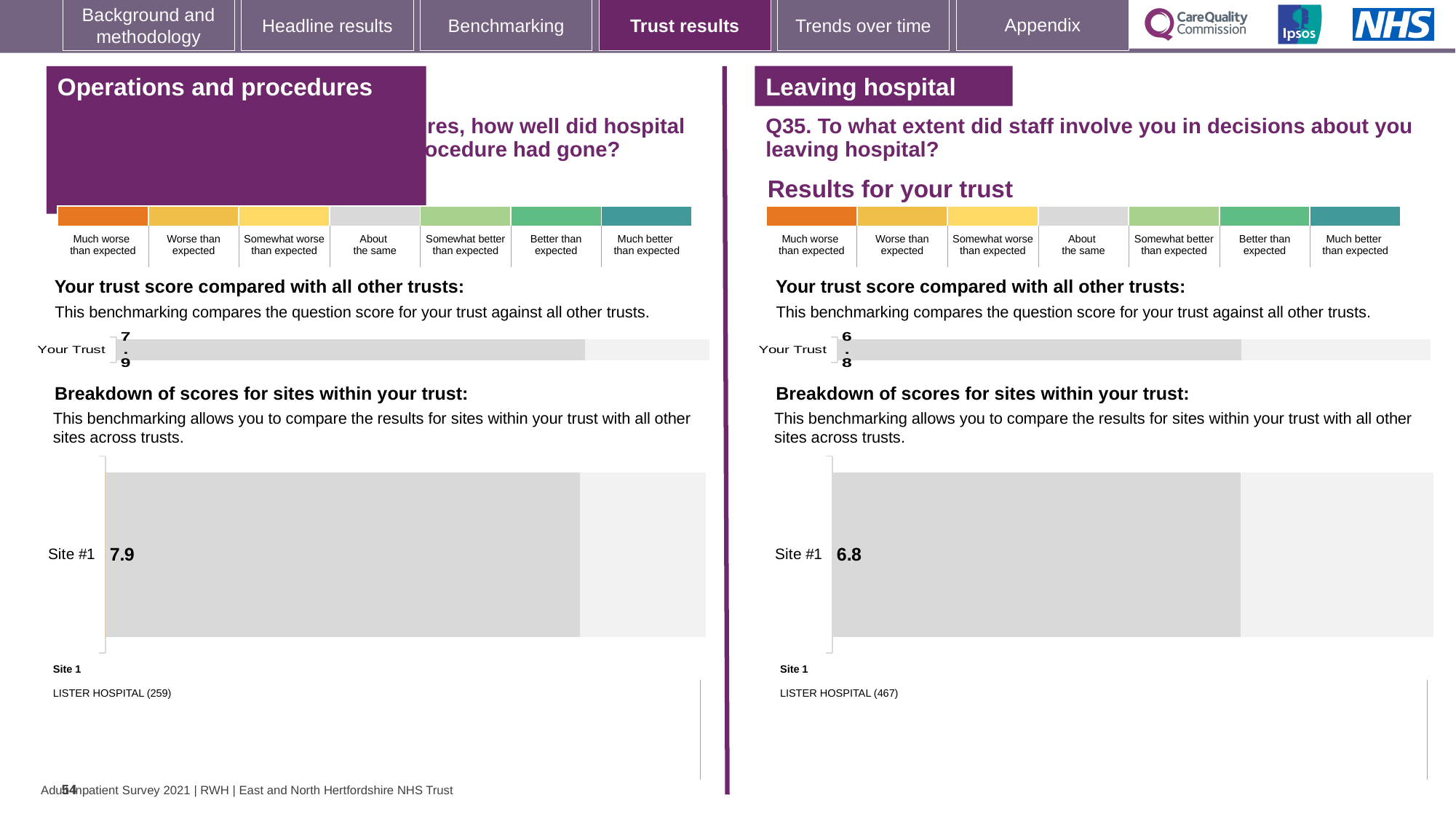
Which is larger: the 'Your Trust' score in the left-hand 'Operations and procedures' chart or the 'Your Trust' score in the right-hand 'Leaving hospital' chart? Operations and procedures (7.9) How many sites are shown in the left-hand 'Breakdown of scores for sites within your trust' chart? 1 What kind of chart is used in the right-hand 'Breakdown of scores for sites within your trust' section? Bar chart On the right-hand 'Leaving hospital' section, what is the 'Your Trust' score shown in the trust score bar chart? 6.8 How many sites are shown in the right-hand 'Breakdown of scores for sites within your trust' chart? 1 In the right-hand 'Breakdown of scores for sites within your trust' chart (Leaving hospital), what is the score for Site #1? 6.8 What kind of chart is used to show the 'Your Trust' score in the left-hand 'Operations and procedures' section? Bar chart Which hospital is listed as Site 1 beneath the right-hand 'Leaving hospital' breakdown chart? LISTER HOSPITAL (467) In the left-hand 'Breakdown of scores for sites within your trust' chart, what is the score for Site #1? 7.9 On the left-hand 'Operations and procedures' section, what is the 'Your Trust' score shown in the trust score bar chart? 7.9 What is the difference between the Site #1 score in the left-hand 'Operations and procedures' breakdown chart and the Site #1 score in the right-hand 'Leaving hospital' breakdown chart? 1.1 Which hospital is listed as Site 1 beneath the left-hand 'Operations and procedures' breakdown chart? LISTER HOSPITAL (259)